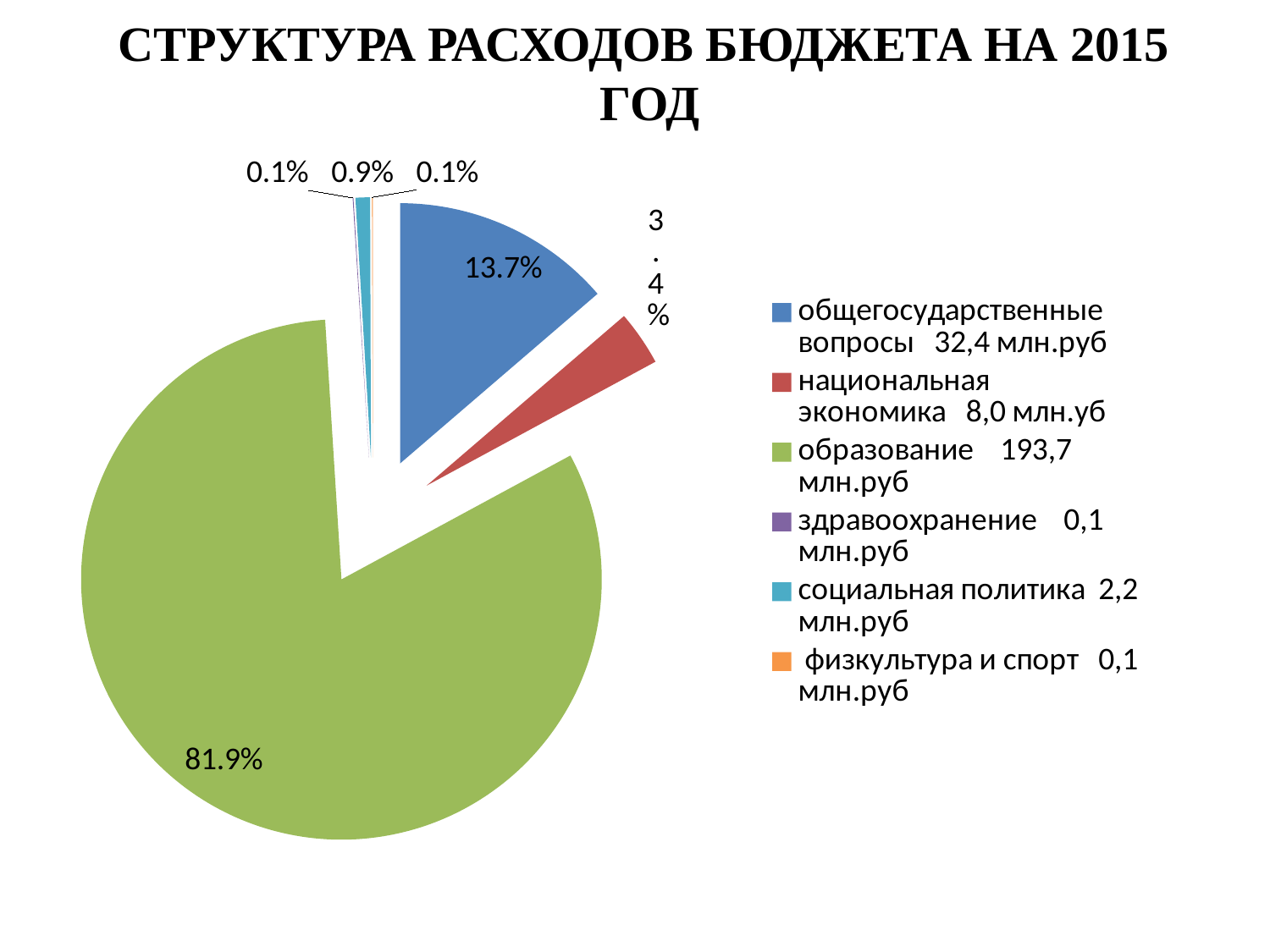
According to the legend, what amount in млн.руб is given for образование? 193,7 млн.руб What is the title of the chart? СТРУКТУРА РАСХОДОВ БЮДЖЕТА НА 2015 ГОД What share of the pie does общегосударственные вопросы take? 13.7% What share of the pie does здравоохранение take? 0.1% What share of the pie does образование take? 81.9% What kind of chart is shown on the slide? pie chart What share of the pie does национальная экономика take? 3.4% How many categories does the pie chart show? 6 What share of the pie does социальная политика take? 0.9% Which slice is larger: общегосударственные вопросы or национальная экономика? общегосударственные вопросы What is the difference in percentage points between the образование slice and the общегосударственные вопросы slice? 68.2 Which category has the largest slice of the pie? образование